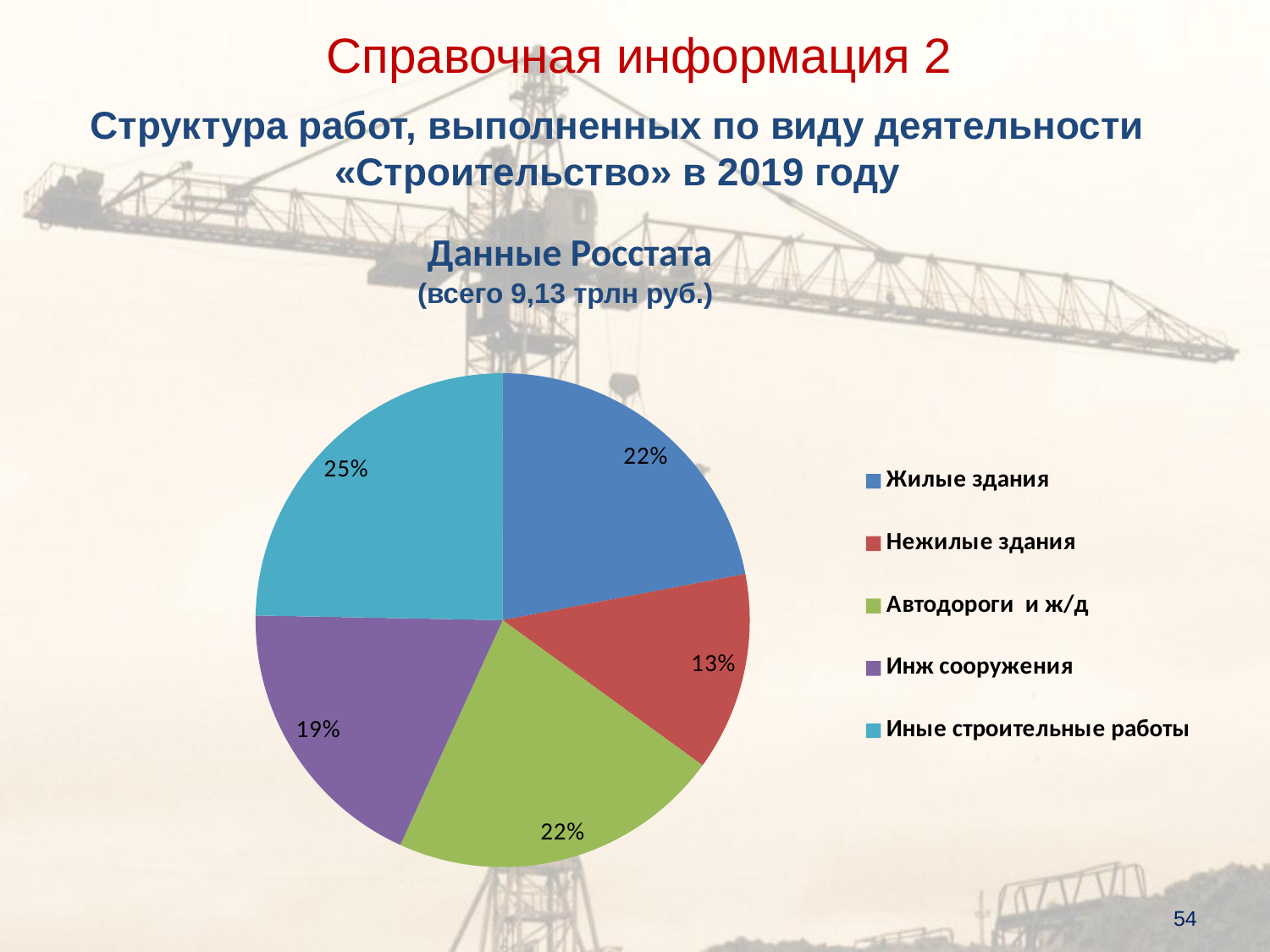
Which is larger, the share for Инж сооружения or the share for Нежилые здания? Инж сооружения What is the value shown for Нежилые здания? 13% What is the value for Автодороги и ж/д? 22% What share does Иные строительные работы have in the pie chart? 25% Which category has the smallest slice of the pie? Нежилые здания What total amount is stated in the chart title? 9,13 трлн руб. What percentage is shown for Инж сооружения? 19% What share of the pie does Жилые здания account for? 22% What is the difference in percentage points between Иные строительные работы and Нежилые здания? 12 What type of chart is shown on the slide? pie chart Which category has the largest slice of the pie? Иные строительные работы How many slices does the pie chart have? 5